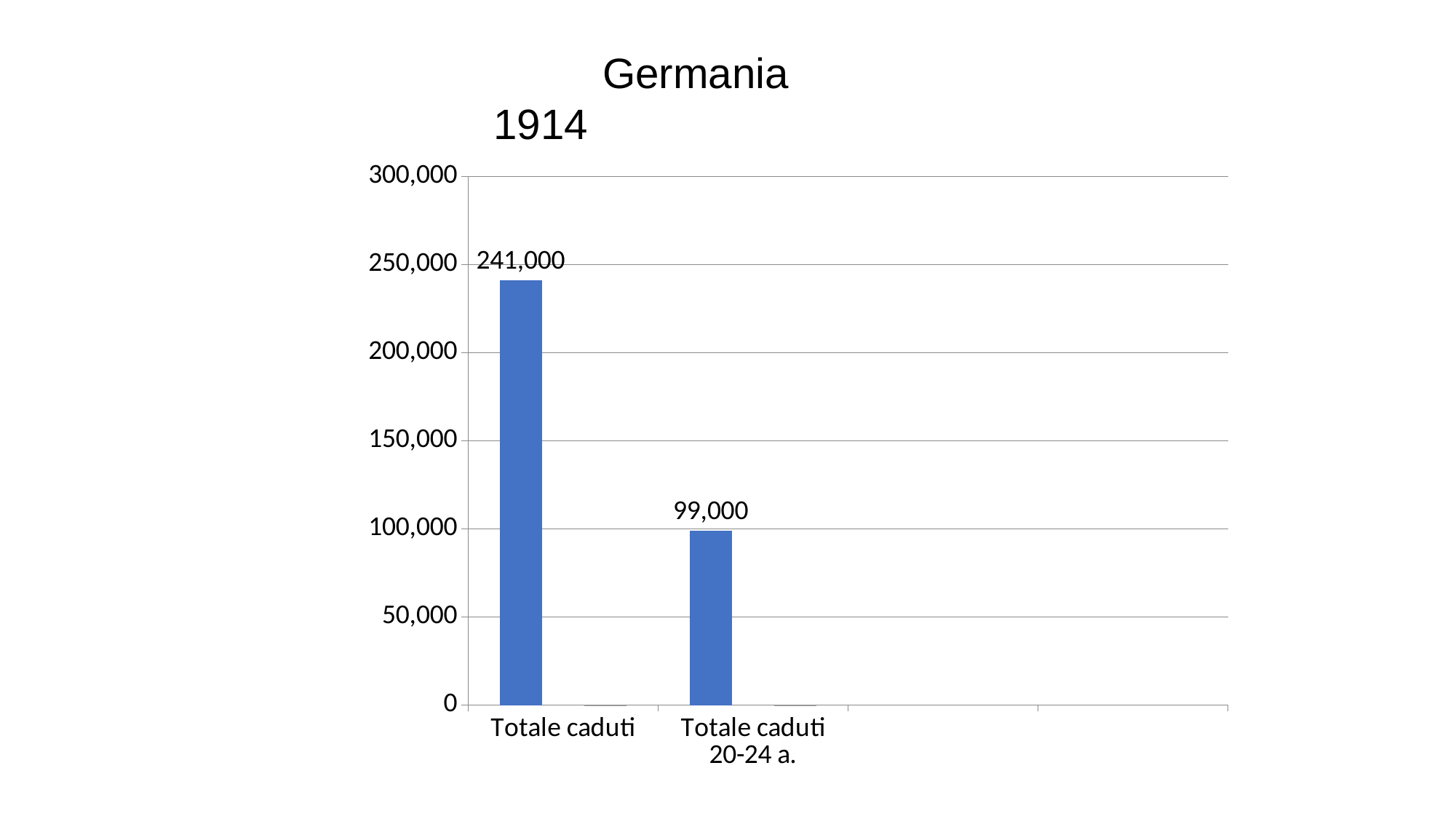
What kind of chart is shown on the slide? bar chart What is the value for "Totale caduti 20-24 a."? 99,000 What is the value for "Totale caduti"? 241,000 Is the value for "Totale caduti 20-24 a." greater or less than 100,000? less What is the title of the chart? Germania 1914 Is the value for "Totale caduti" greater or less than 200,000? greater Which is larger, the value for "Totale caduti" or the value for "Totale caduti 20-24 a."? Totale caduti Which category has the lowest value? Totale caduti 20-24 a. How many categories are shown in the chart? 2 What is the highest value shown on the vertical axis? 300,000 What is the difference between the value for "Totale caduti" and the value for "Totale caduti 20-24 a."? 142,000 Which category has the highest value? Totale caduti